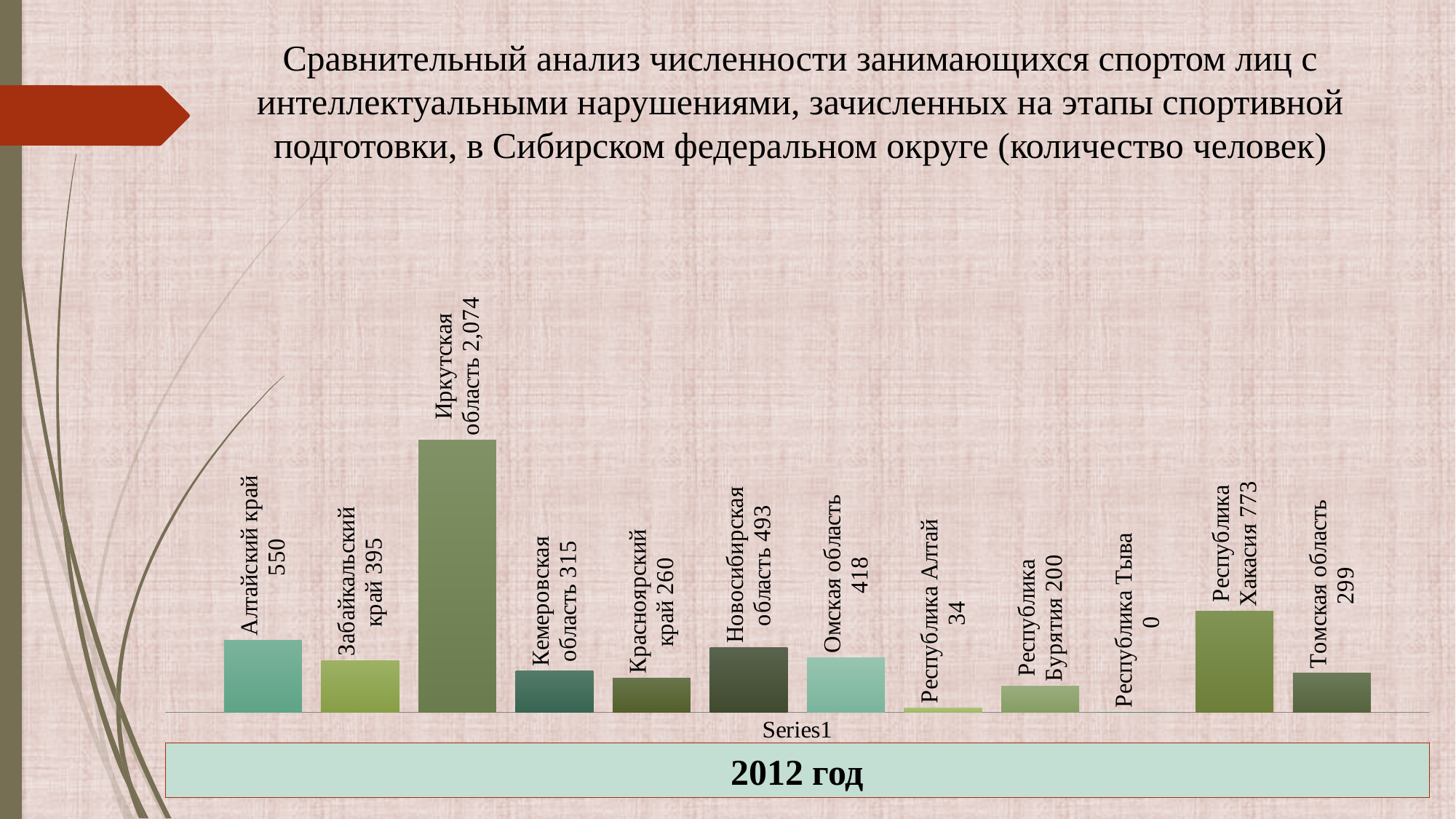
What kind of chart is shown on the slide? Bar chart Which region has the lowest value? Республика Тыва What is the difference between the values for Республика Хакасия and Новосибирская область? 280 What is the difference between the values for Алтайский край and Забайкальский край? 155 What is the value for Омская область? 418 What is the value for Иркутская область? 2,074 How many regions are shown in the chart? 12 Which is larger, the value for Кемеровская область or the value for Красноярский край? Кемеровская область Which region has the highest value? Иркутская область What year is indicated in the label below the chart? 2012 год What is the value for Республика Хакасия? 773 What is the value for Республика Тыва? 0